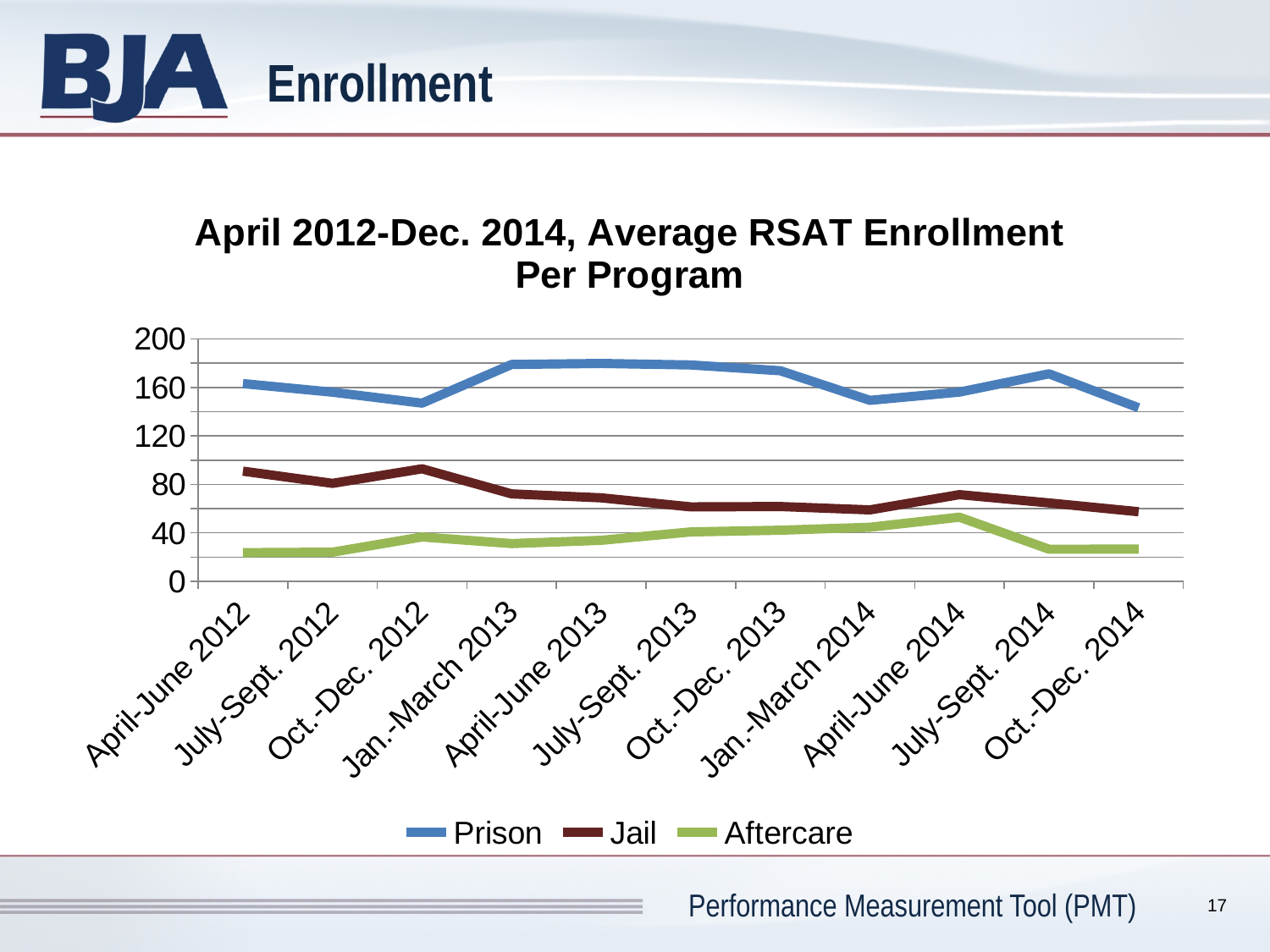
Is the value for Prison in April-June 2013 greater or less than 160? greater In which period does Aftercare reach its highest value? April-June 2014 Which series has the highest values across all periods? Prison What is the title of the chart? April 2012-Dec. 2014, Average RSAT Enrollment Per Program How many time periods are plotted along the x axis? 11 What kind of chart is shown on the slide? line chart Is the value for Aftercare in April-June 2014 greater or less than 40? greater How many series does the legend list? 3 Is the value for Jail in Oct.-Dec. 2012 greater or less than 80? greater Does the Jail line rise or fall overall from April-June 2012 to Oct.-Dec. 2014? fall Which series is plotted with the blue line? Prison